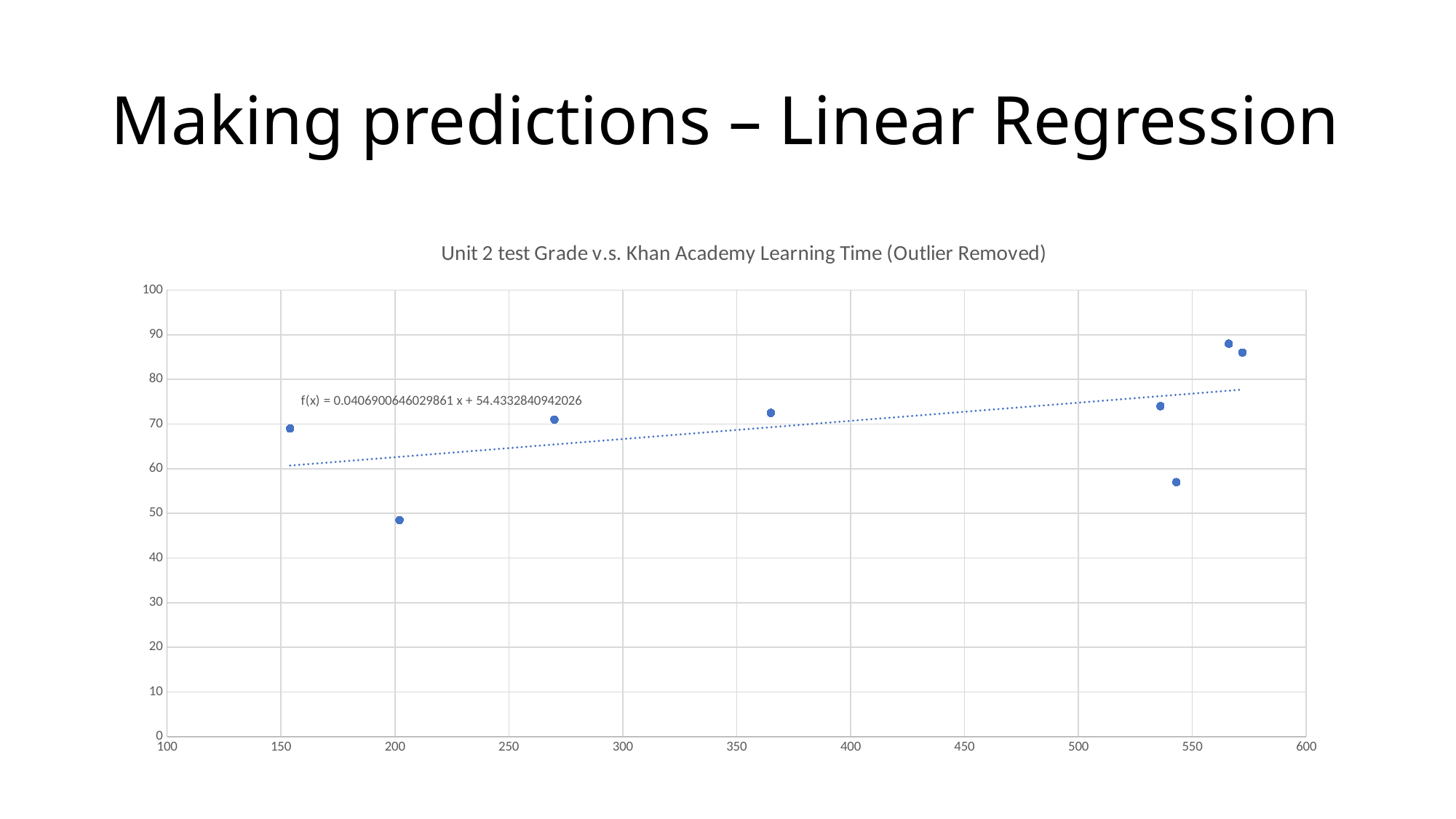
What is the title of the chart? Unit 2 test Grade v.s. Khan Academy Learning Time (Outlier Removed) How many data points are plotted on the chart? 8 What kind of chart is shown on the slide? Scatter chart What is the slope of the fitted line f(x) shown on the chart? 0.0406900646029861 How many plotted points have an x value greater than 500? 4 What is the full equation of the trendline printed on the chart? f(x) = 0.0406900646029861 x + 54.4332840942026 Is the lowest plotted point greater or less than 40? greater Is the lowest plotted point greater or less than 60? less What is the maximum value shown on the x axis? 600 Is the highest plotted point greater or less than 90? less What is the intercept of the fitted line f(x) shown on the chart? 54.4332840942026 Does the dotted trendline rise or fall as x increases? Rises